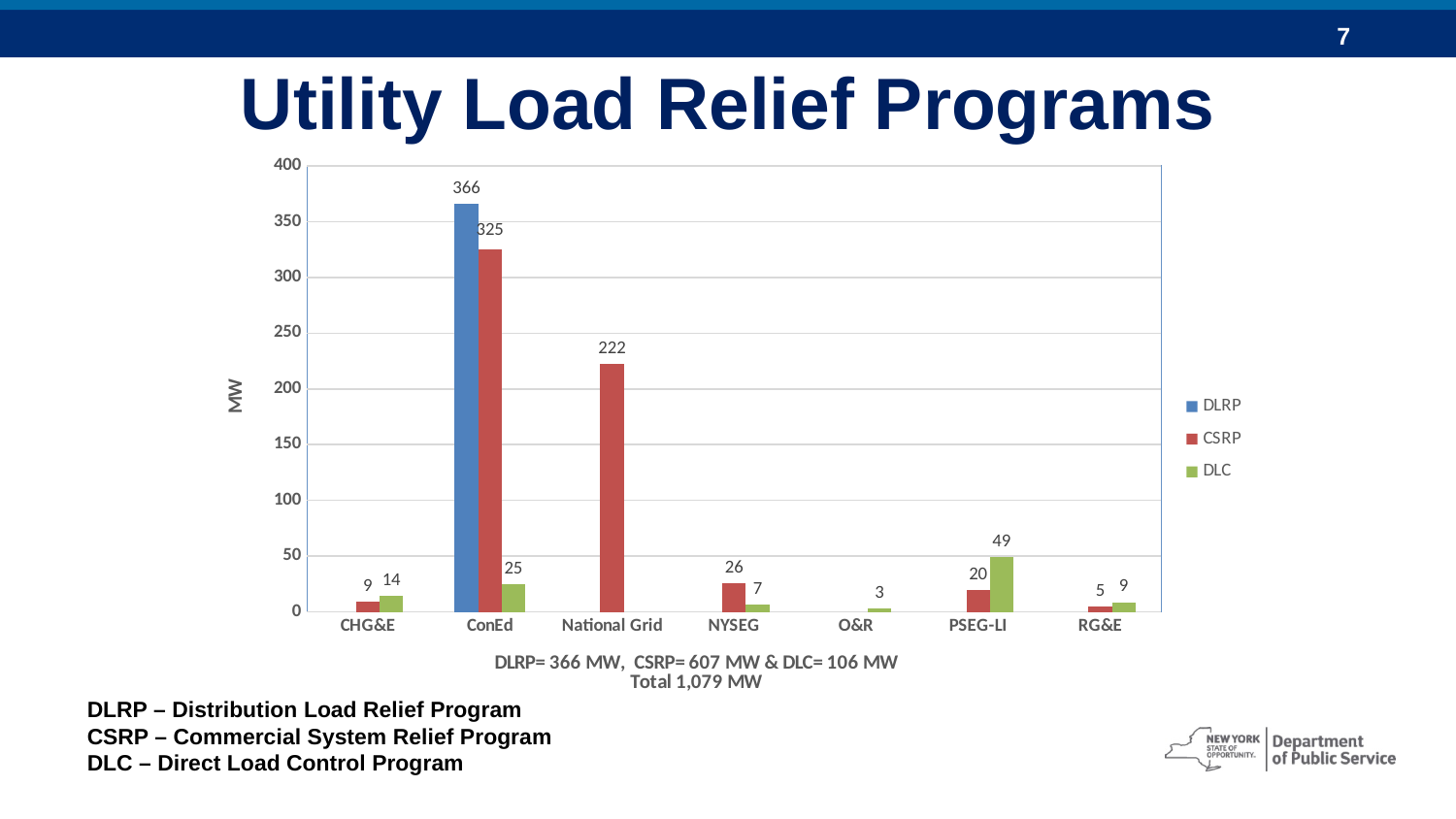
What is the CSRP value for National Grid? 222 Is the CSRP value for National Grid greater or less than 200? greater Which is larger for PSEG-LI, the CSRP value or the DLC value? DLC What is the DLC value for PSEG-LI? 49 What is the CSRP value for ConEd? 325 What is the DLC value for CHG&E? 14 Which utility has the highest CSRP value? ConEd What kind of chart is shown on the slide? Bar chart How many utilities are shown on the x axis? 7 What is the difference between the DLRP and CSRP values for ConEd? 41 Which utility has the lowest DLC value? O&R How many series does the legend list? 3